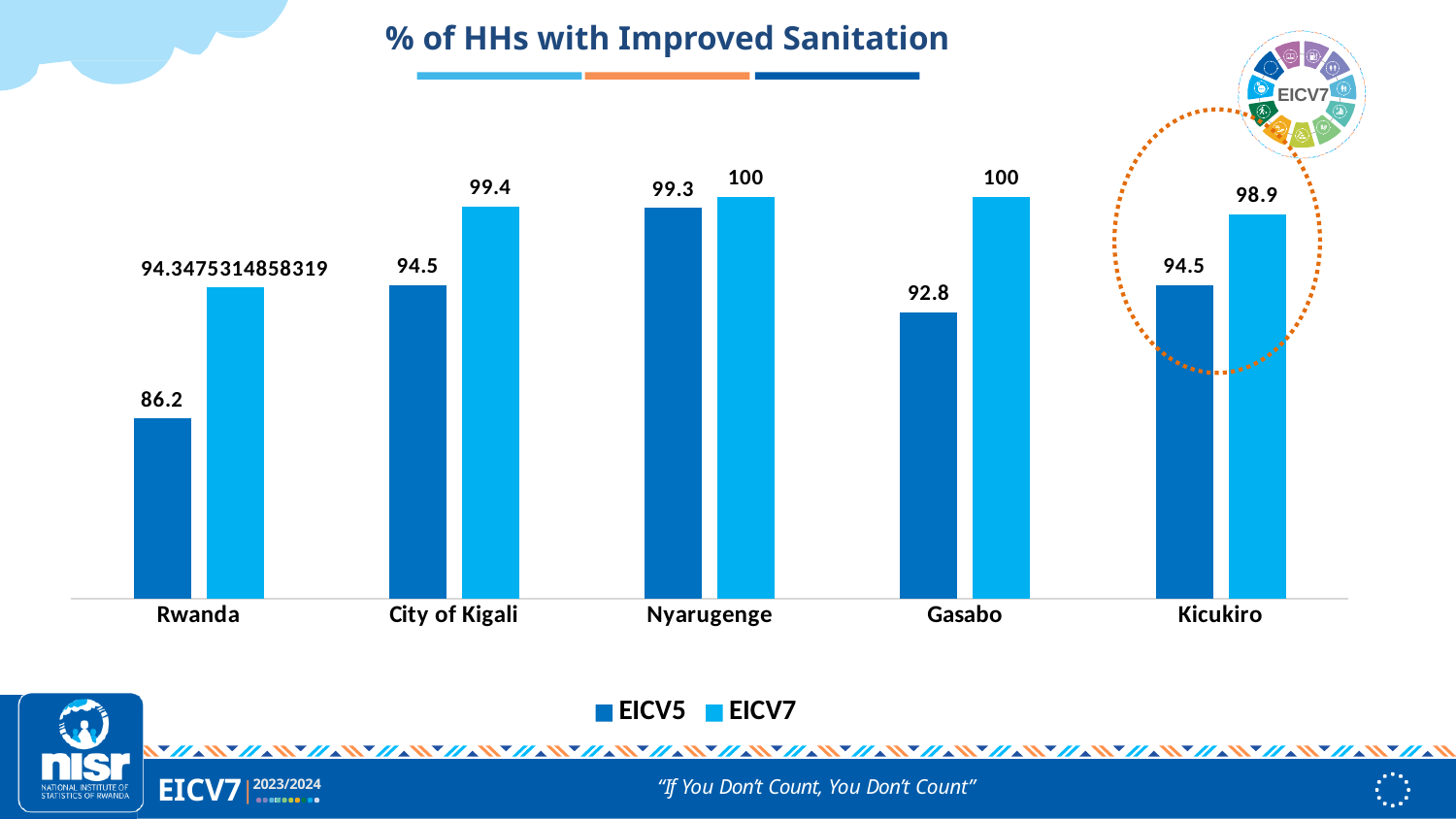
What is the difference between the EICV7 and EICV5 values for Gasabo? 7.2 What is the EICV7 value for City of Kigali? 99.4 What is the EICV5 value for Rwanda? 86.2 What is the EICV5 value for Gasabo? 92.8 What kind of chart is shown on the slide? Bar chart What is the difference between the EICV5 values for City of Kigali and Rwanda? 8.3 What is the EICV7 value for Kicukiro? 98.9 Which has the larger EICV5 value, Gasabo or Kicukiro? Kicukiro Which category has the lowest EICV5 value? Rwanda How many series does the legend list? 2 How many categories are shown on the x axis? 5 Which category has the highest EICV5 value? Nyarugenge